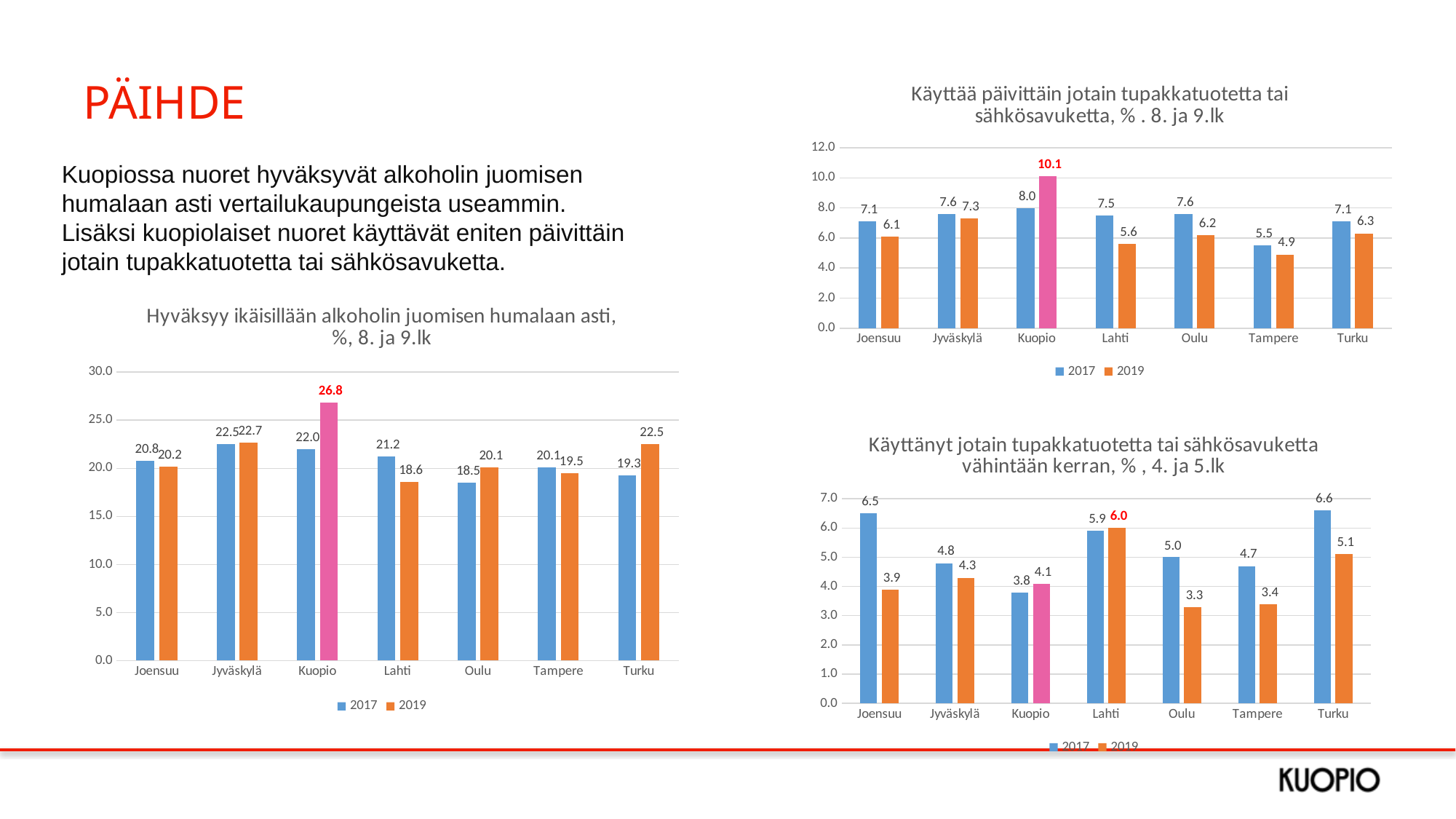
In the chart 'Hyväksyy ikäisillään alkoholin juomisen humalaan asti', which city has the lowest 2017 value? Oulu What type of chart is the chart 'Käyttänyt jotain tupakkatuotetta tai sähkösavuketta vähintään kerran'? Bar chart In the chart 'Hyväksyy ikäisillään alkoholin juomisen humalaan asti', how many cities are shown on the x axis? 7 In the chart 'Käyttänyt jotain tupakkatuotetta tai sähkösavuketta vähintään kerran', which city has the lowest 2019 value? Oulu In the chart 'Käyttää päivittäin jotain tupakkatuotetta tai sähkösavuketta', how many series does the legend list? 2 In the chart 'Hyväksyy ikäisillään alkoholin juomisen humalaan asti', what is the 2019 value for Kuopio? 26.8 In the chart 'Käyttänyt jotain tupakkatuotetta tai sähkösavuketta vähintään kerran', what is the difference between the 2017 and 2019 values for Joensuu? 2.6 In the chart 'Käyttänyt jotain tupakkatuotetta tai sähkösavuketta vähintään kerran', what is the 2017 value for Turku? 6.6 In the chart 'Käyttää päivittäin jotain tupakkatuotetta tai sähkösavuketta', which is larger for Tampere: the 2017 value or the 2019 value? 2017 In the chart 'Hyväksyy ikäisillään alkoholin juomisen humalaan asti', what is the difference between the 2019 and 2017 values for Kuopio? 4.8 In the chart 'Käyttää päivittäin jotain tupakkatuotetta tai sähkösavuketta', which city has the highest 2019 value? Kuopio In the chart 'Käyttää päivittäin jotain tupakkatuotetta tai sähkösavuketta', what is the 2019 value for Lahti? 5.6